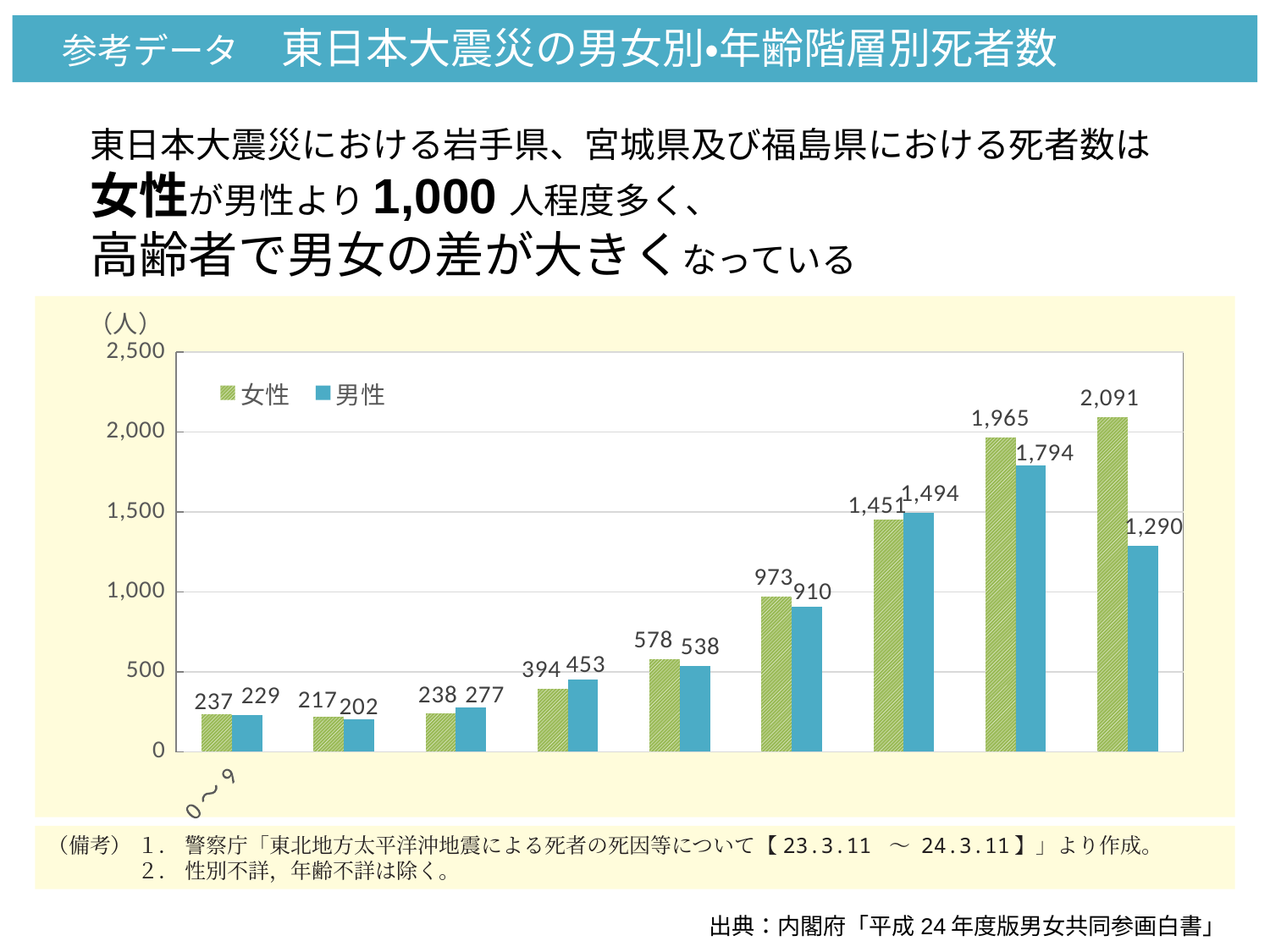
How many age groups are plotted on the chart? 9 What kind of chart is shown on the slide? bar chart How many series does the legend list? 2 What is the lowest value shown for the 男性 series? 202 In the rightmost age group, what is the difference between the 女性 value (2,091) and the 男性 value (1,290)? 801 What unit is shown at the top of the vertical axis? 人 What is the highest value shown for the 女性 series? 2,091 In the rightmost age group, which series has the larger value, 女性 or 男性? 女性 What is the value for 女性 in the 0～9 age group? 237 What is the highest value shown for the 男性 series? 1,794 In the 0～9 age group, which series has the larger value, 女性 or 男性? 女性 What is the value for 男性 in the 0～9 age group? 229